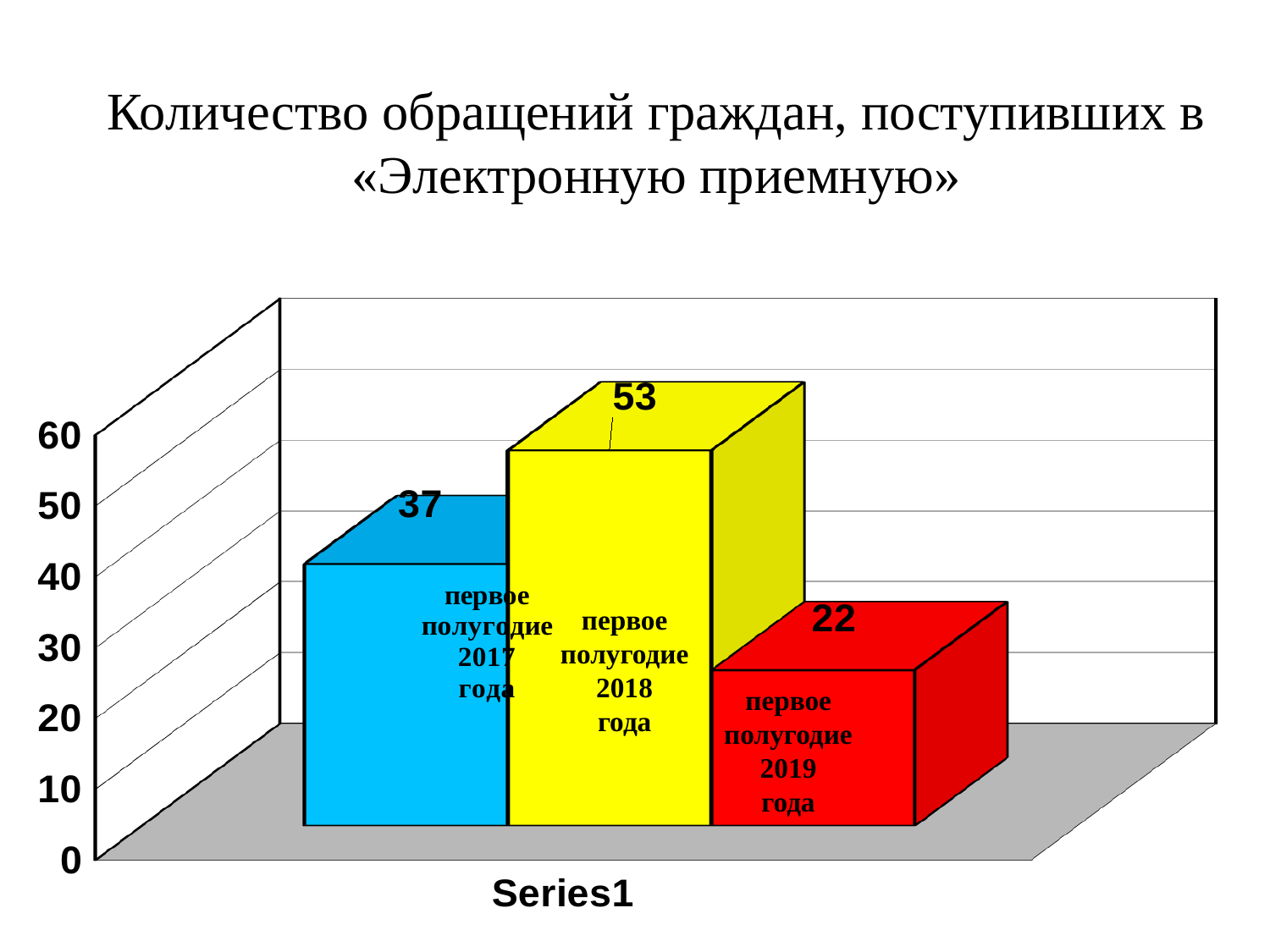
What kind of chart is shown on the slide? bar chart What is the value for первое полугодие 2018 года? 53 Which is larger: the value for первое полугодие 2017 года or первое полугодие 2019 года? первое полугодие 2017 года What is the difference between the values for первое полугодие 2018 года and первое полугодие 2017 года? 16 What is the difference between the values for первое полугодие 2017 года and первое полугодие 2019 года? 15 What is the value for первое полугодие 2019 года? 22 What is the value for первое полугодие 2017 года? 37 What is the title of the chart? Количество обращений граждан, поступивших в «Электронную приемную» Is the value for первое полугодие 2018 года greater or less than 50? greater Which period has the lowest number of appeals? первое полугодие 2019 года How many bars are shown in the chart? 3 Which period has the highest number of appeals? первое полугодие 2018 года